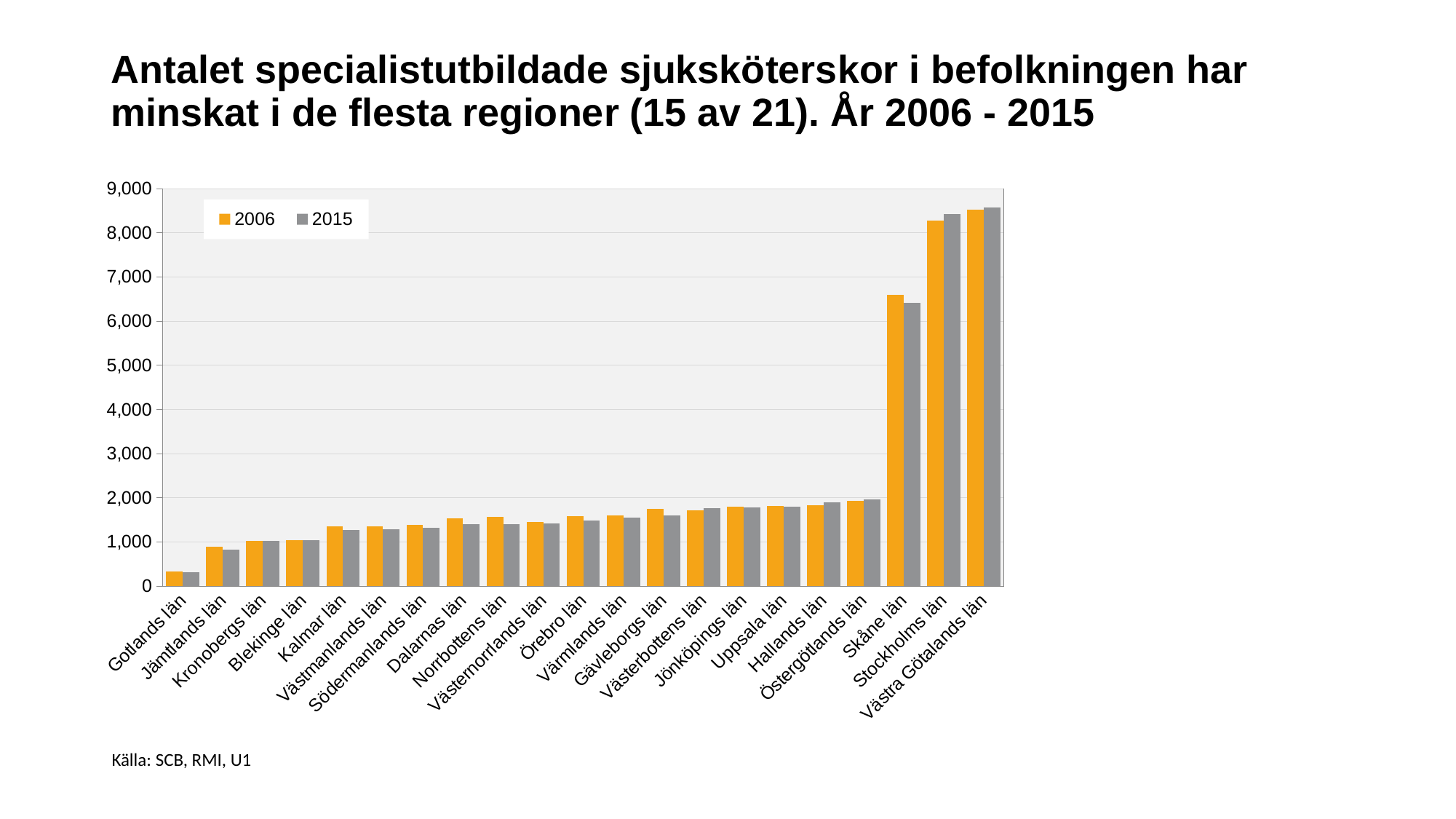
Do the 2006 values generally rise or fall moving from left to right along the x axis? rise What kind of chart is shown on the slide? bar chart How many series does the chart's legend list? 2 Is the 2015 value for Stockholms län greater or less than 8,000? greater Which region has the highest value for 2015? Västra Götalands län Is the 2006 value for Skåne län greater or less than 6,000? greater Which region has the lowest value for 2006? Gotlands län For Skåne län, which is larger: the 2006 value or the 2015 value? 2006 For 2006, which is larger: Stockholms län or Skåne län? Stockholms län How many regions (categories) are shown on the x axis of the chart? 21 Is the 2006 value for Gotlands län greater or less than 1,000? less